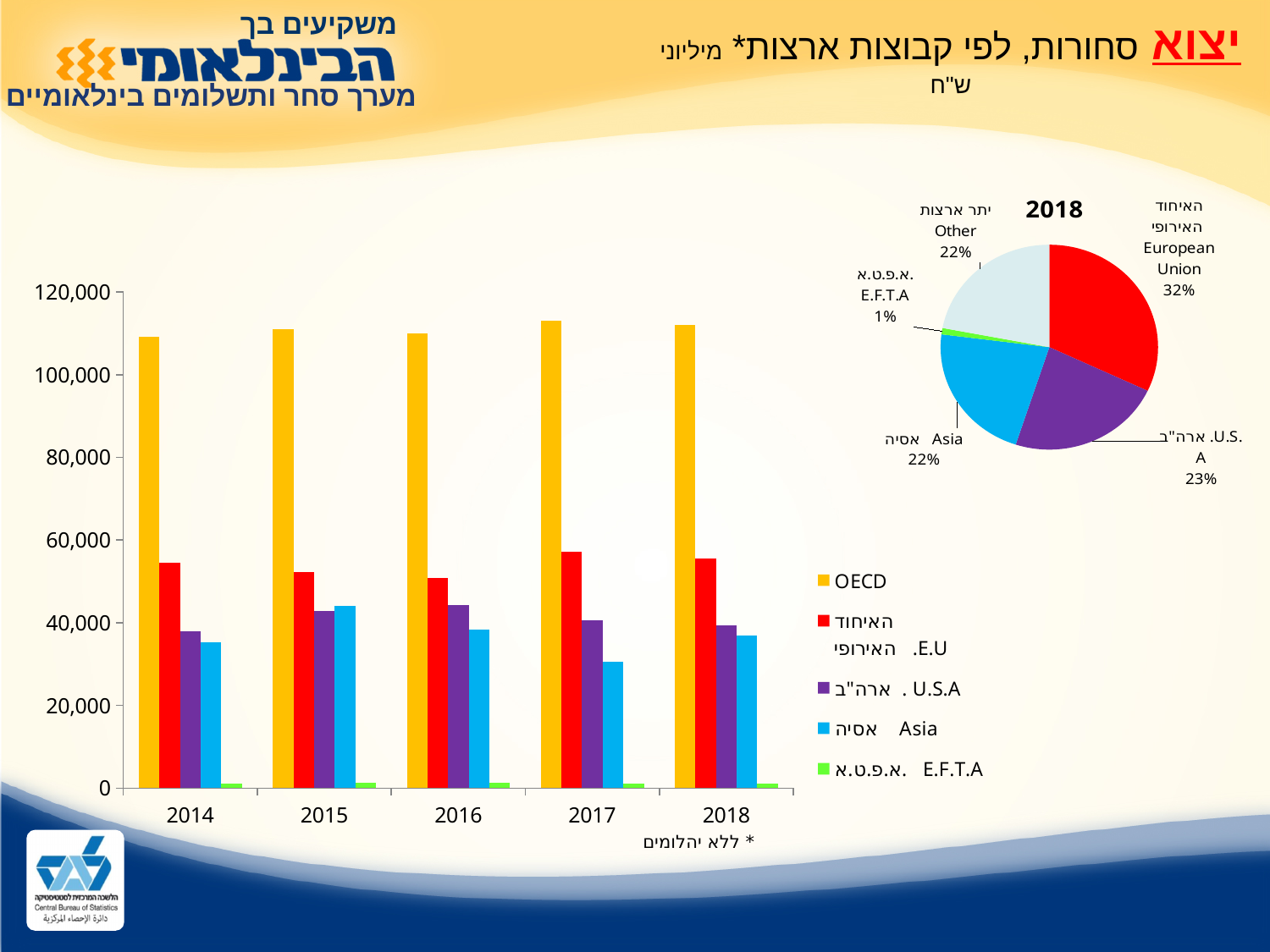
In the bar chart on the left, is the OECD value for 2014 greater or less than 100,000? greater What kind of chart is the large chart on the left showing exports by year? bar chart In the bar chart on the left, how many years are shown on the x axis? 5 In the bar chart on the left, how many series does the legend list? 5 In the bar chart on the left, is the Asia value for 2017 greater or less than 40,000? less In the pie chart for 2018, how many slices are shown? 5 In the bar chart on the left, which series has the highest value in every year? OECD In the pie chart for 2018, how many percentage points larger is the European Union share than the U.S.A share? 9 In the pie chart for 2018, what share of exports goes to the European Union? 32% In the pie chart for 2018, which country group has the largest slice? European Union In the pie chart for 2018, what share of exports goes to the U.S.A? 23% In the pie chart for 2018, which country group has the smallest slice? E.F.T.A